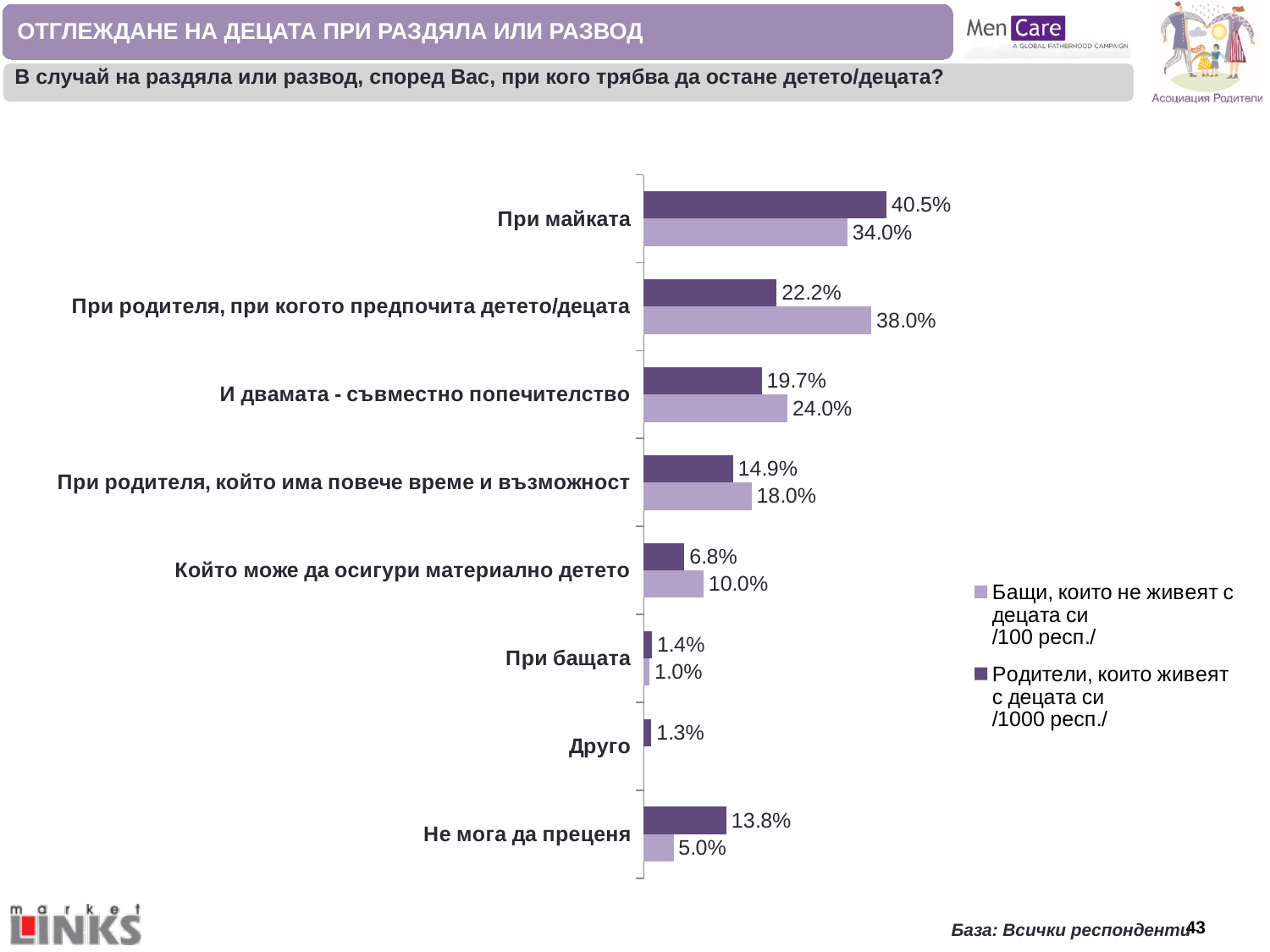
Which category has the highest value for the series "Родители, които живеят с децата си /1000 респ./"? При майката For "И двамата - съвместно попечителство", which series has the larger value? Бащи, които не живеят с децата си /100 респ./ How many series does the legend list? 2 What type of chart is shown on the slide? bar chart What is the difference between the two series for "При родителя, при когото предпочита детето/децата"? 15.8% What is the difference between the two series for "Не мога да преценя"? 8.8% How many categories are shown on the chart? 8 What is the value for "Не мога да преценя" for the series "Бащи, които не живеят с децата си /100 респ./"? 5.0% What is the value for "При родителя, при когото предпочита детето/децата" for the series "Бащи, които не живеят с децата си /100 респ./"? 38.0% Which category has a value for only one of the two series? Друго Which category has the lowest value for the series "Бащи, които не живеят с децата си /100 респ./"? При бащата What is the value for "При майката" for the series "Родители, които живеят с децата си /1000 респ./"? 40.5%